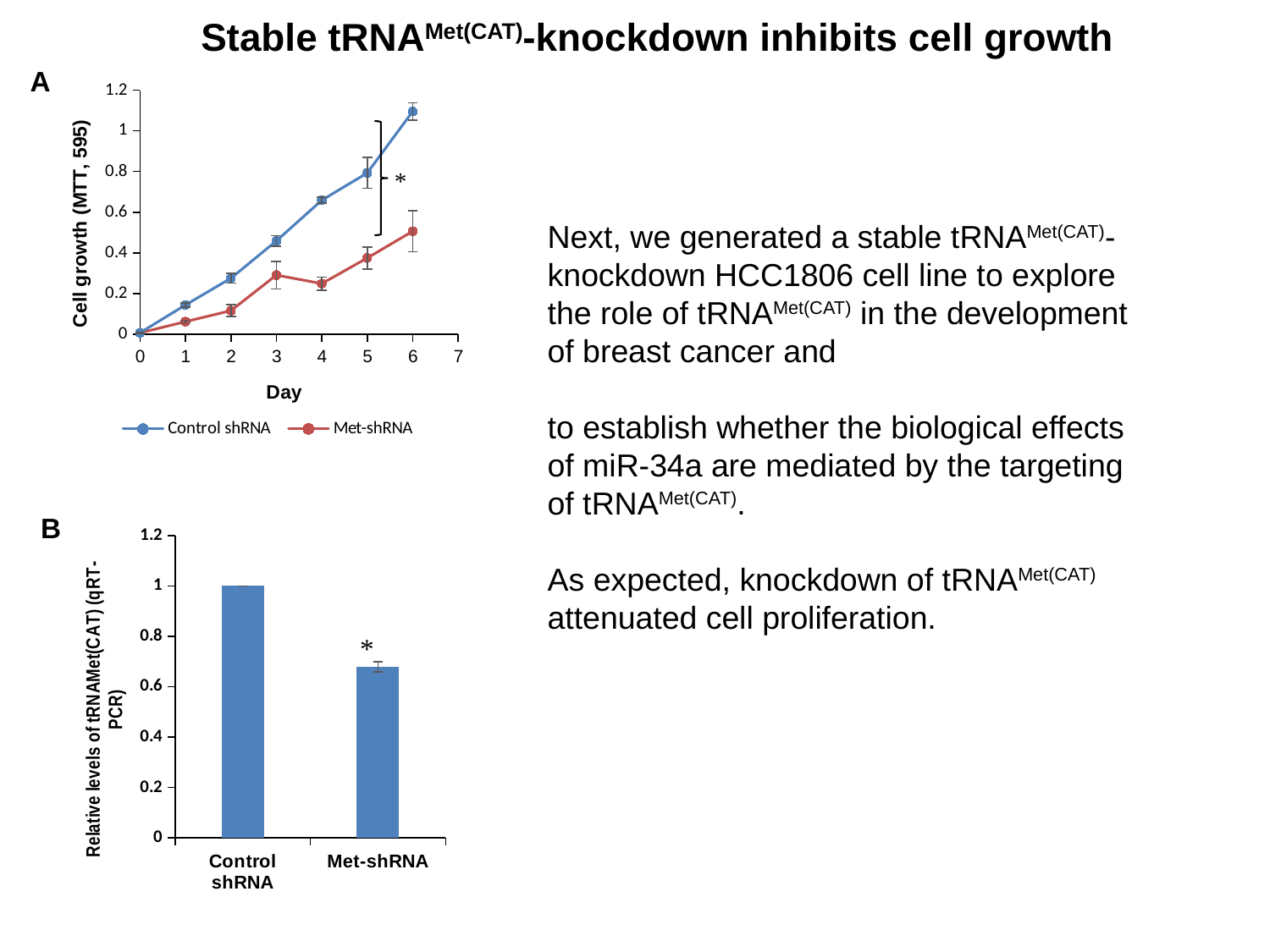
What kind of chart is chart B (Relative levels of tRNAMet(CAT))? bar chart In chart A, which series has the higher value at day 6? Control shRNA In chart A, is the Control shRNA value at day 4 greater or less than 0.6? greater How many series does the legend of chart A list? 2 In chart A, is the Control shRNA value at day 6 greater or less than 1? greater In chart A, is the Met-shRNA value at day 6 greater or less than 0.6? less In chart B, what is the value for Control shRNA? 1 How many categories are shown in chart B? 2 What are the two series named in the legend of chart A? Control shRNA and Met-shRNA What kind of chart is chart A (Cell growth)? line chart In chart A, does the Control shRNA series rise or fall from day 0 to day 6? rise